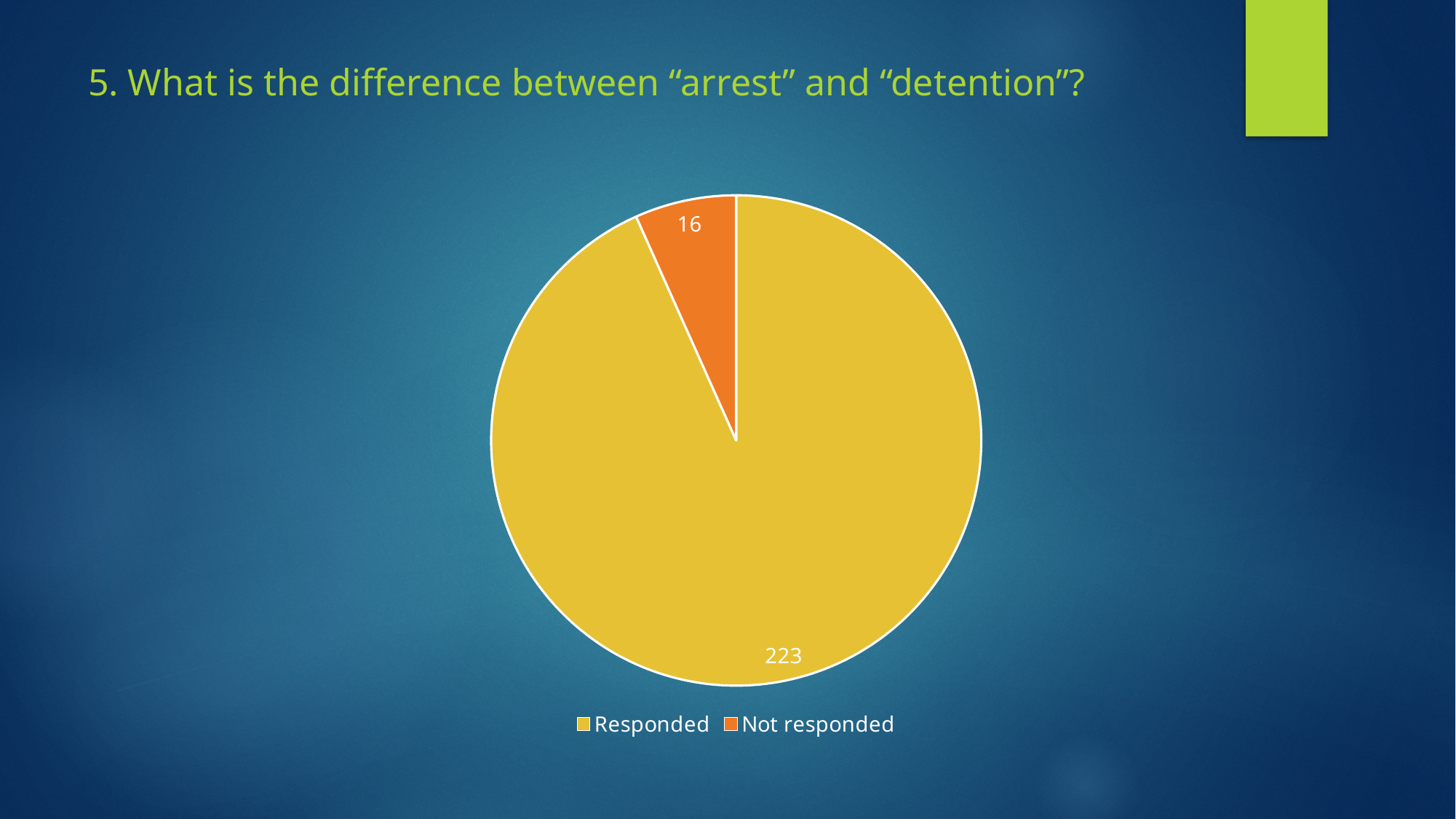
What kind of chart is shown on the slide? pie chart What are the two legend entries of the chart? Responded, Not responded What is the value for Responded? 223 What is the value for Not responded? 16 Which is larger, Responded or Not responded? Responded What is the total of all slices in the pie chart? 239 How many slices does the pie chart have? 2 What colour is the Not responded slice? orange Which category has the smallest slice? Not responded What is the difference between the Responded and Not responded values? 207 Which category has the largest slice? Responded